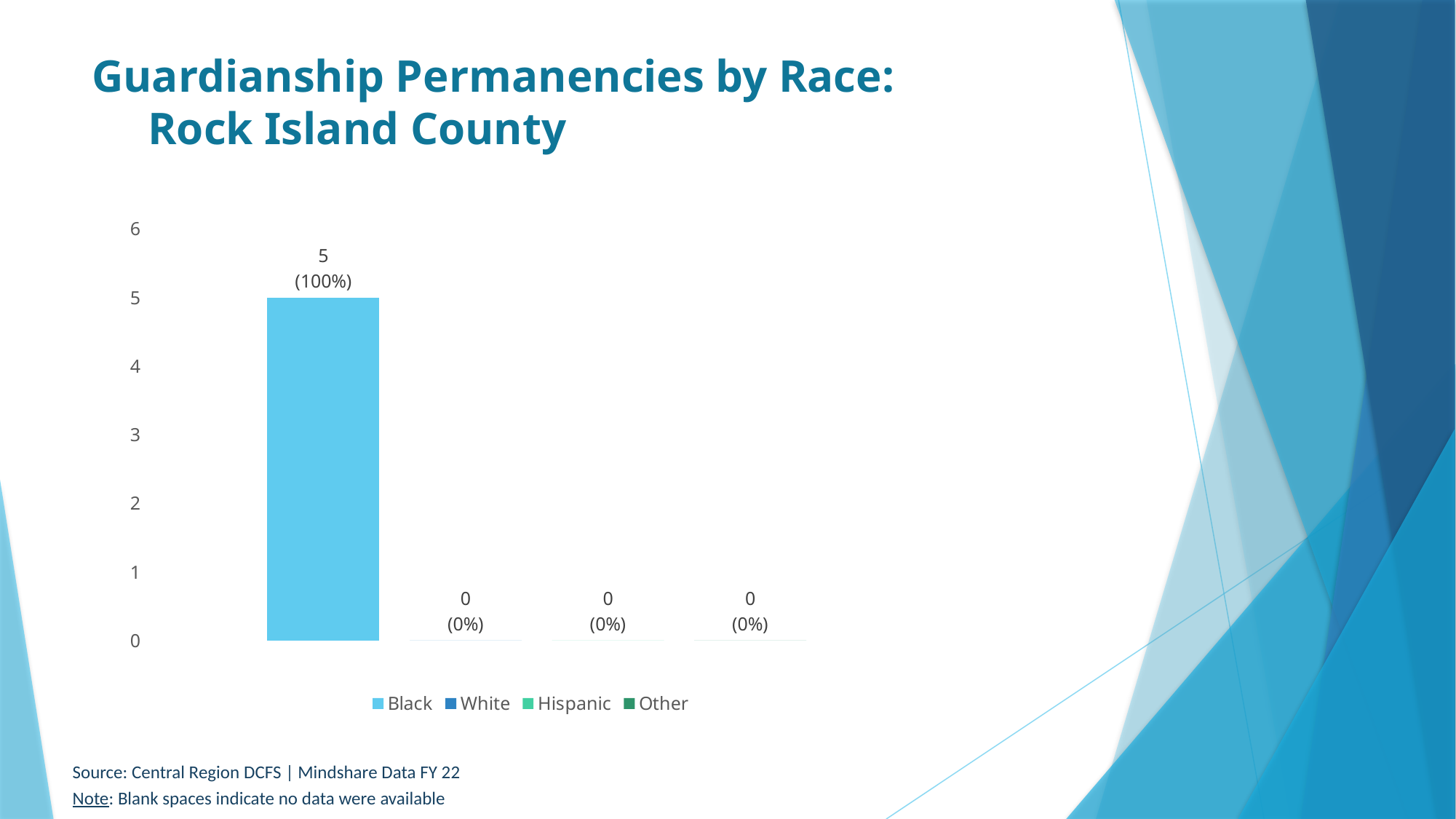
What is the value for Hispanic? 0 How many series does the legend list? 4 Which is larger, the value for Black or the value for Hispanic? Black Is the value for Black greater or less than 4? greater Which race category has the highest value? Black What is the difference between the values for Black and White? 5 What is the value for Black in the Guardianship Permanencies by Race: Rock Island County chart? 5 What percentage is shown for Black? 100% What is the value for White? 0 What is the title of the chart on the slide? Guardianship Permanencies by Race: Rock Island County What percentage is shown for Other? 0% What kind of chart is shown on the slide? Bar chart